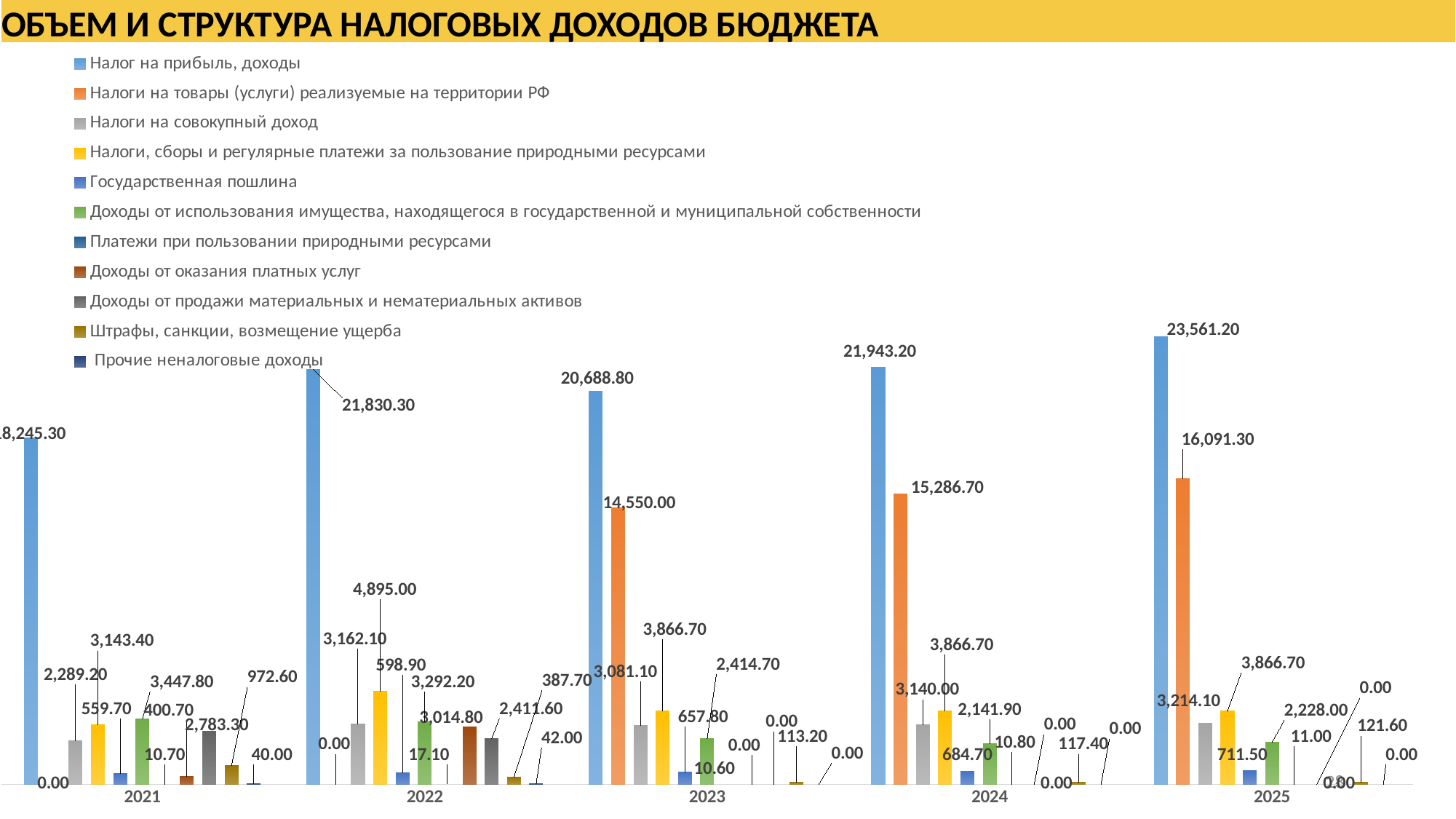
In which year is 'Налог на прибыль, доходы' highest? 2025 Which is larger in 2023: 'Налог на прибыль, доходы' or 'Налоги на товары (услуги) реализуемые на территории РФ'? Налог на прибыль, доходы What is the value of 'Налоги на товары (услуги) реализуемые на территории РФ' in 2025? 16,091.30 What is the value of 'Налоги на товары (услуги) реализуемые на территории РФ' in 2024? 15,286.70 How many series does the legend list? 11 What kind of chart is shown on the slide? bar chart Does 'Налоги на товары (услуги) реализуемые на территории РФ' rise or fall from 2023 to 2025? rise What is the value of 'Налог на прибыль, доходы' in 2025? 23,561.20 What is the title of the chart? ОБЪЕМ И СТРУКТУРА НАЛОГОВЫХ ДОХОДОВ БЮДЖЕТА How many years are shown along the x axis? 5 What is the difference between 'Налог на прибыль, доходы' in 2025 and in 2024? 1,618.00 What is the value of 'Налог на прибыль, доходы' in 2022? 21,830.30